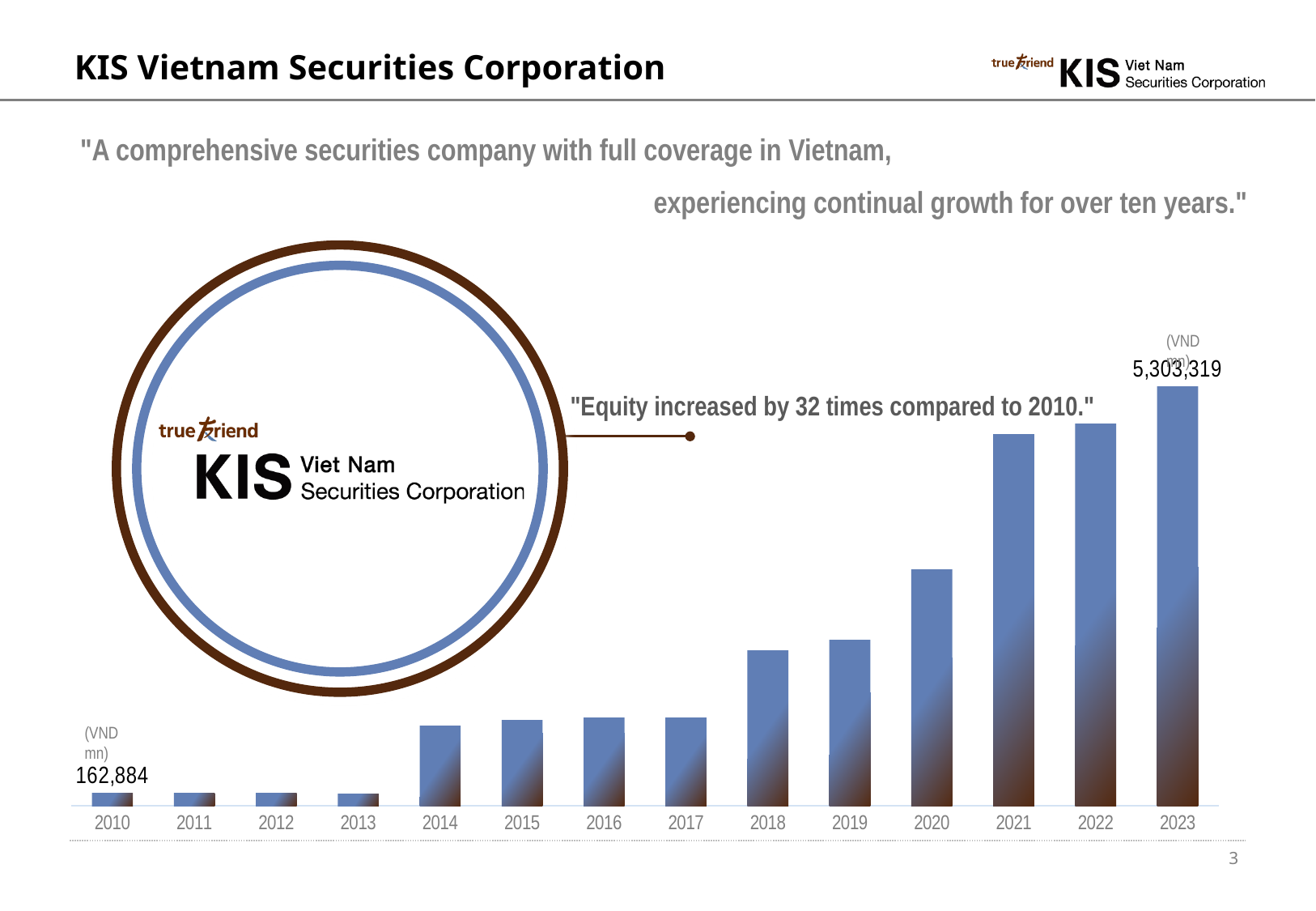
What kind of chart is used to show the equity values? bar chart What is the difference between the 2023 value and the 2010 value? 5,140,435 What is the equity value shown for 2023? 5,303,319 Which is larger, the bar for 2020 or the bar for 2019? 2020 What is the equity value shown for 2010? 162,884 Which is larger, the bar for 2021 or the bar for 2022? 2022 According to the annotation on the slide, by how many times did equity increase compared to 2010? 32 times Which year has the highest bar in the chart? 2023 What unit is given for the values in the chart? VND mn Which is larger, the bar for 2018 or the bar for 2014? 2018 How many years are shown on the x axis of the chart? 14 Do the values generally rise or fall from 2010 to 2023? rise